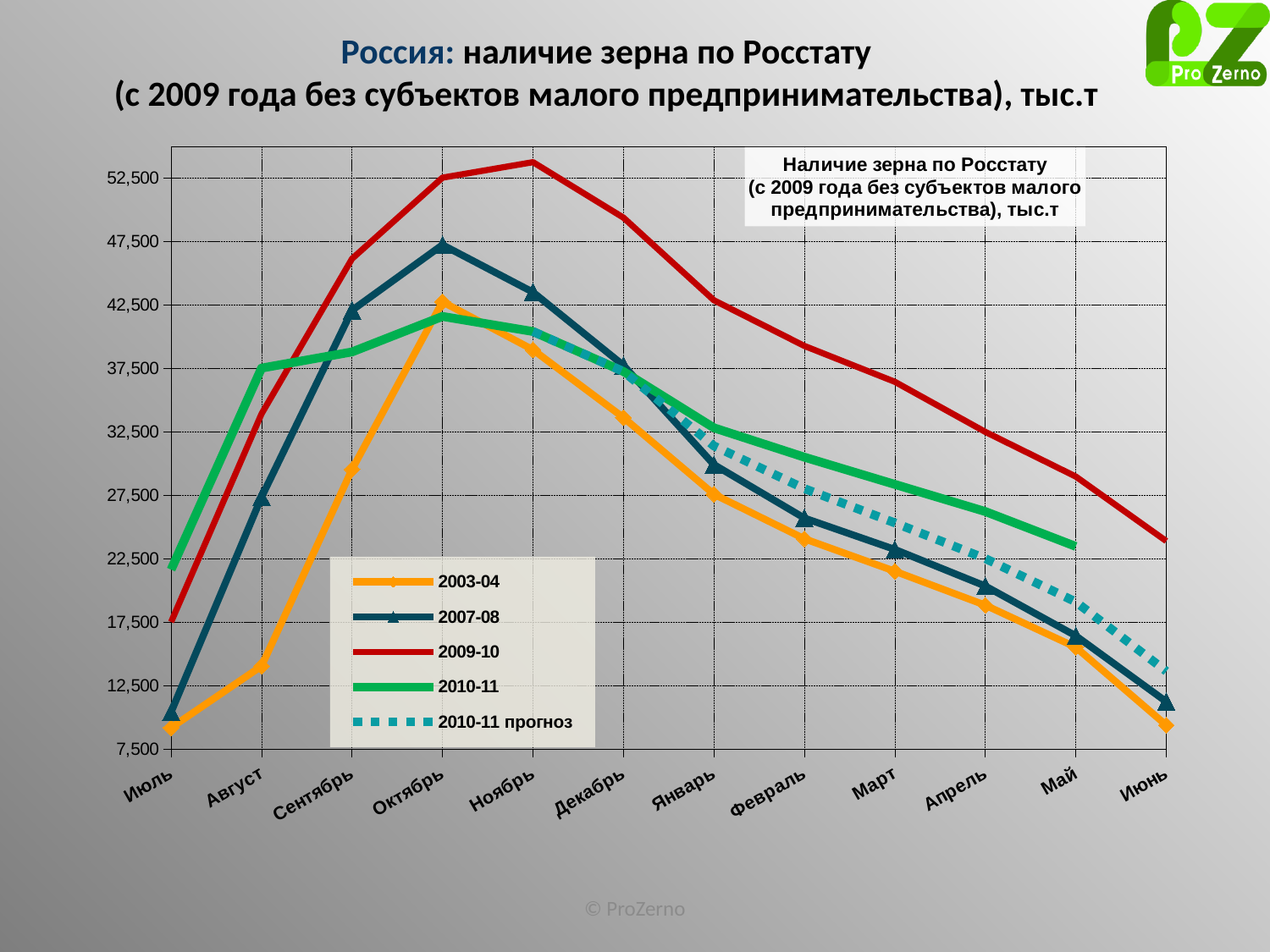
Is the value for 2009-10 in Октябрь greater or less than 47,500? greater In which month does the 2007-08 series reach its highest value? Октябрь In Октябрь, which series has the larger value: 2009-10 or 2007-08? 2009-10 How many months are shown along the x axis? 12 How many series does the legend list? 5 What kind of chart is shown on the slide? line chart In which month does the 2003-04 series reach its highest value? Октябрь Does the 2009-10 series rise or fall from Ноябрь to Июнь? fall Is the value for 2003-04 in Июль greater or less than 12,500? less In Июль, which series has the larger value: 2010-11 or 2003-04? 2010-11 Which series in the legend is drawn with a dotted line? 2010-11 прогноз Is the value for 2009-10 in Март greater or less than 32,500? greater